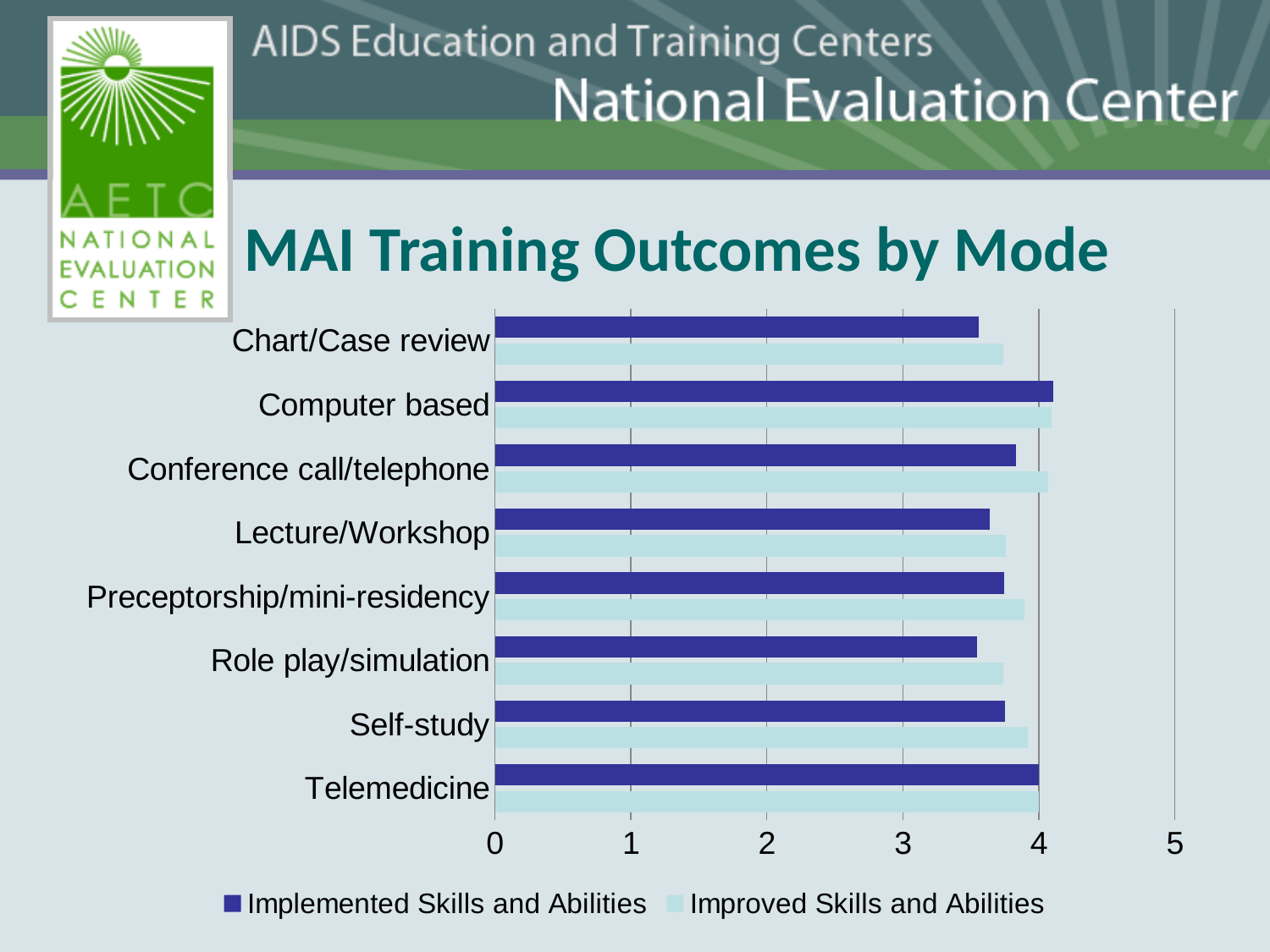
Is the Improved Skills and Abilities value for Lecture/Workshop greater or less than 4? less Which series is shown in dark blue in the legend? Implemented Skills and Abilities Which has the larger Implemented Skills and Abilities value, Computer based or Chart/Case review? Computer based Which has the larger Improved Skills and Abilities value, Conference call/telephone or Lecture/Workshop? Conference call/telephone How many series does the legend list? 2 Is the Implemented Skills and Abilities value for Computer based greater or less than 4? greater Is the Implemented Skills and Abilities value for Role play/simulation greater or less than 3? greater What is the title of the chart? MAI Training Outcomes by Mode How many training modes (categories) are shown on the chart? 8 What kind of chart is shown on the slide? bar chart